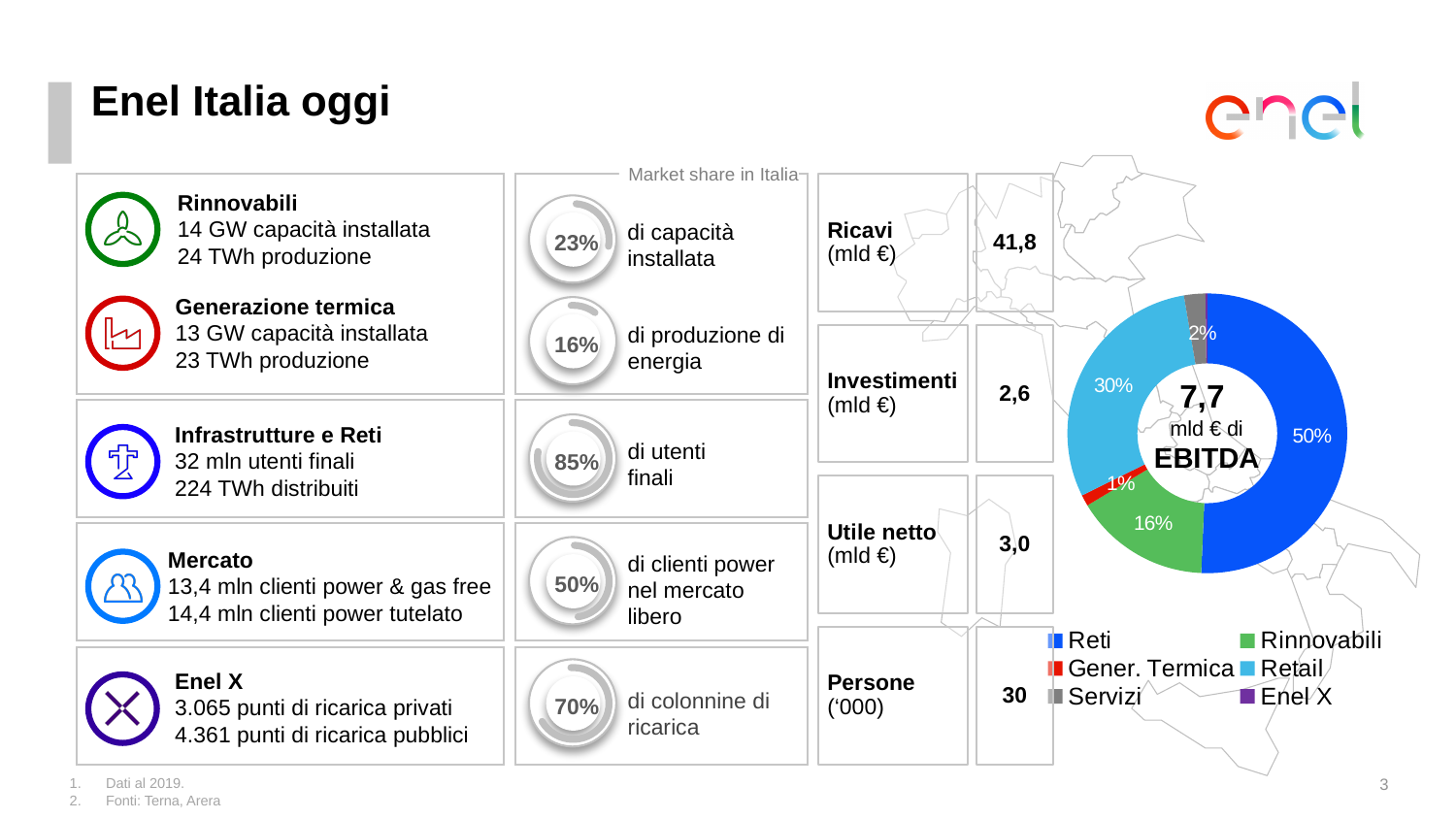
In the EBITDA donut chart, what share is shown for Retail? 30% What kind of chart is used to show the EBITDA breakdown on the right of the slide? Donut (pie) chart In the EBITDA donut chart, which has a larger share, Rinnovabili or Retail? Retail What total EBITDA value is printed in the centre of the donut chart? 7,7 mld € In the EBITDA donut chart, what is the difference in percentage points between the Reti share and the Retail share? 20 percentage points In the EBITDA donut chart, what share is shown for Rinnovabili? 16% In the EBITDA donut chart, which segment has the largest share? Reti How many entries does the legend of the EBITDA donut chart list? 6 In the EBITDA donut chart, which labelled segment has the smallest share? Gener. Termica In the EBITDA donut chart, what share is shown for Gener. Termica? 1% In the EBITDA donut chart, what share is shown for Reti? 50% In the EBITDA donut chart, what share is shown for Servizi? 2%